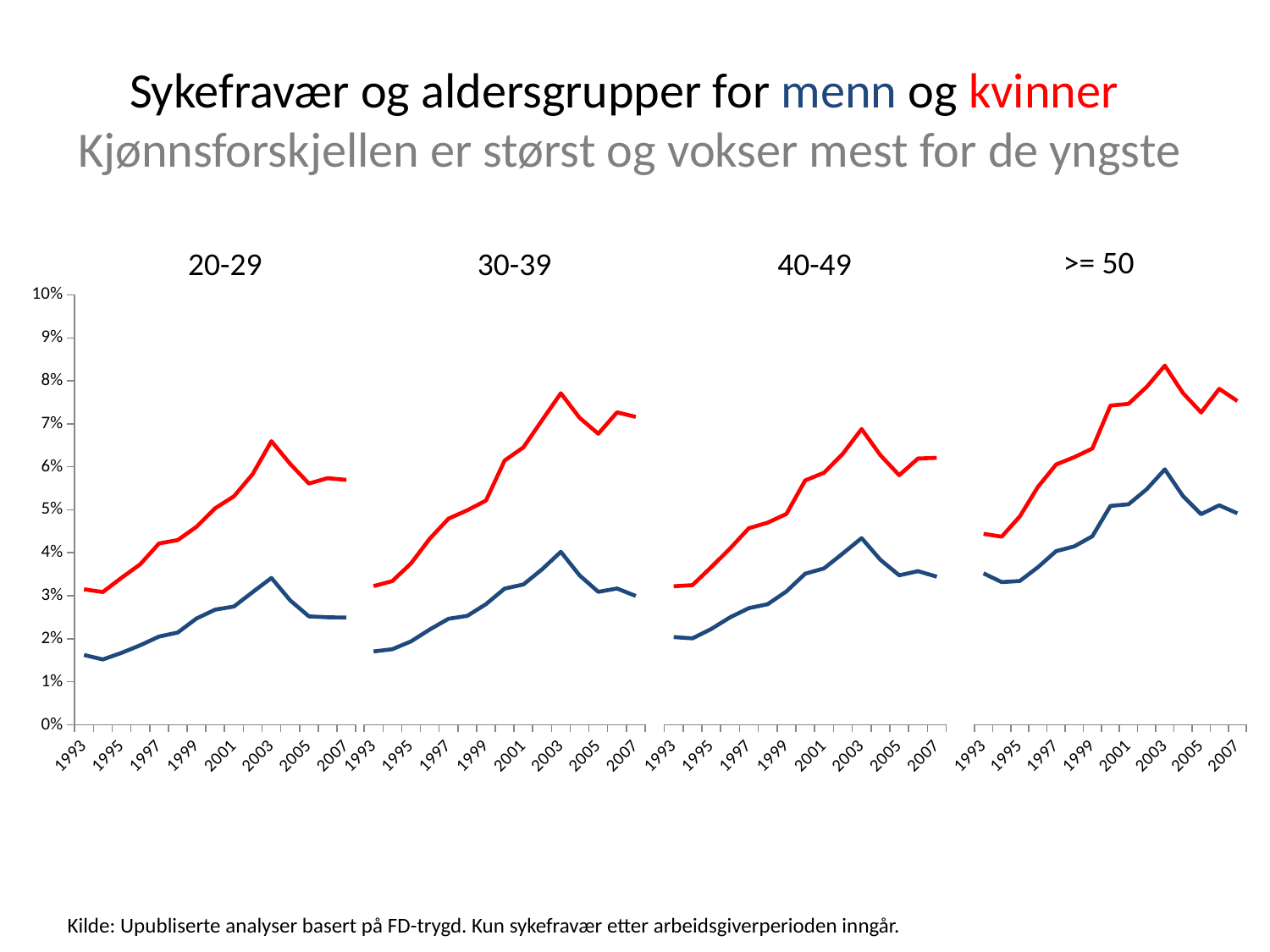
In the 30-39 panel, is the value of the blue line in 2003 greater or less than 3%? greater Which age-group panel contains the highest value of the red line? >= 50 What is the first year and the last year shown on the x axis of each panel? 1993 and 2007 In the 30-39 panel, in which year does the red line reach its highest value? 2003 In the >= 50 panel, does the blue line rise or fall from 1993 to 2003? rise According to the title, which colour represents kvinner? red In the 20-29 panel, is the value of the blue line in 1993 greater or less than 2%? less What kind of chart is used in the four panels on this slide? line chart In the 20-29 panel, is the value of the red line in 2003 greater or less than 6%? greater In the 40-49 panel, which line is higher in 2007, the red line or the blue line? red line How many age-group panels are shown on the slide? 4